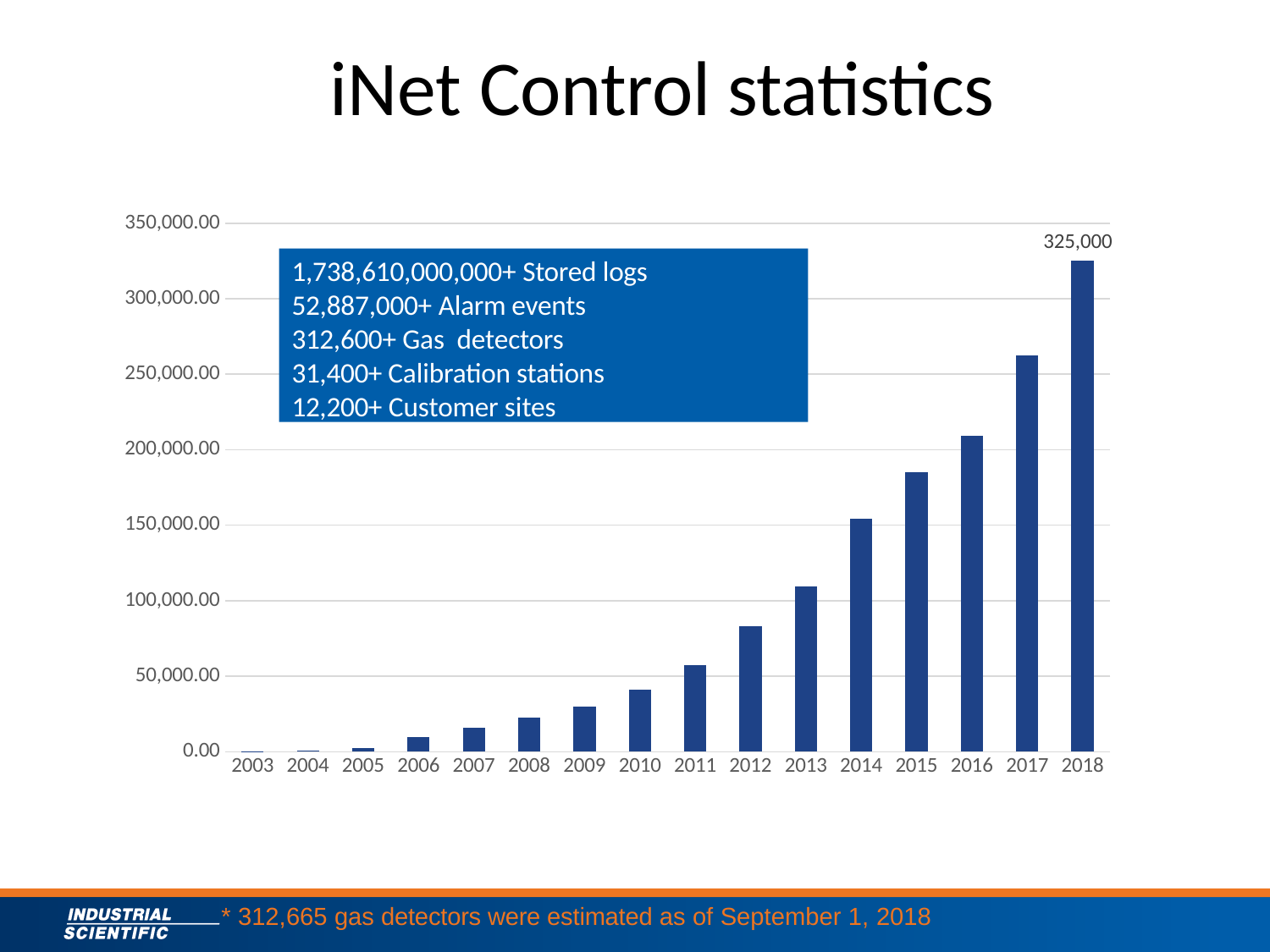
What is the value shown for 2018? 325,000 Is the value for 2016 greater or less than 200,000? greater Is the value for 2015 greater or less than 200,000? less Is the value for 2010 greater or less than 50,000? less Which year has the highest bar? 2018 How many years are shown on the x axis? 16 Do the values rise or fall from 2003 to 2018? Rise Which year has the larger value, 2016 or 2017? 2017 What kind of chart is shown on the slide? Bar chart Which year has the larger value, 2012 or 2013? 2013